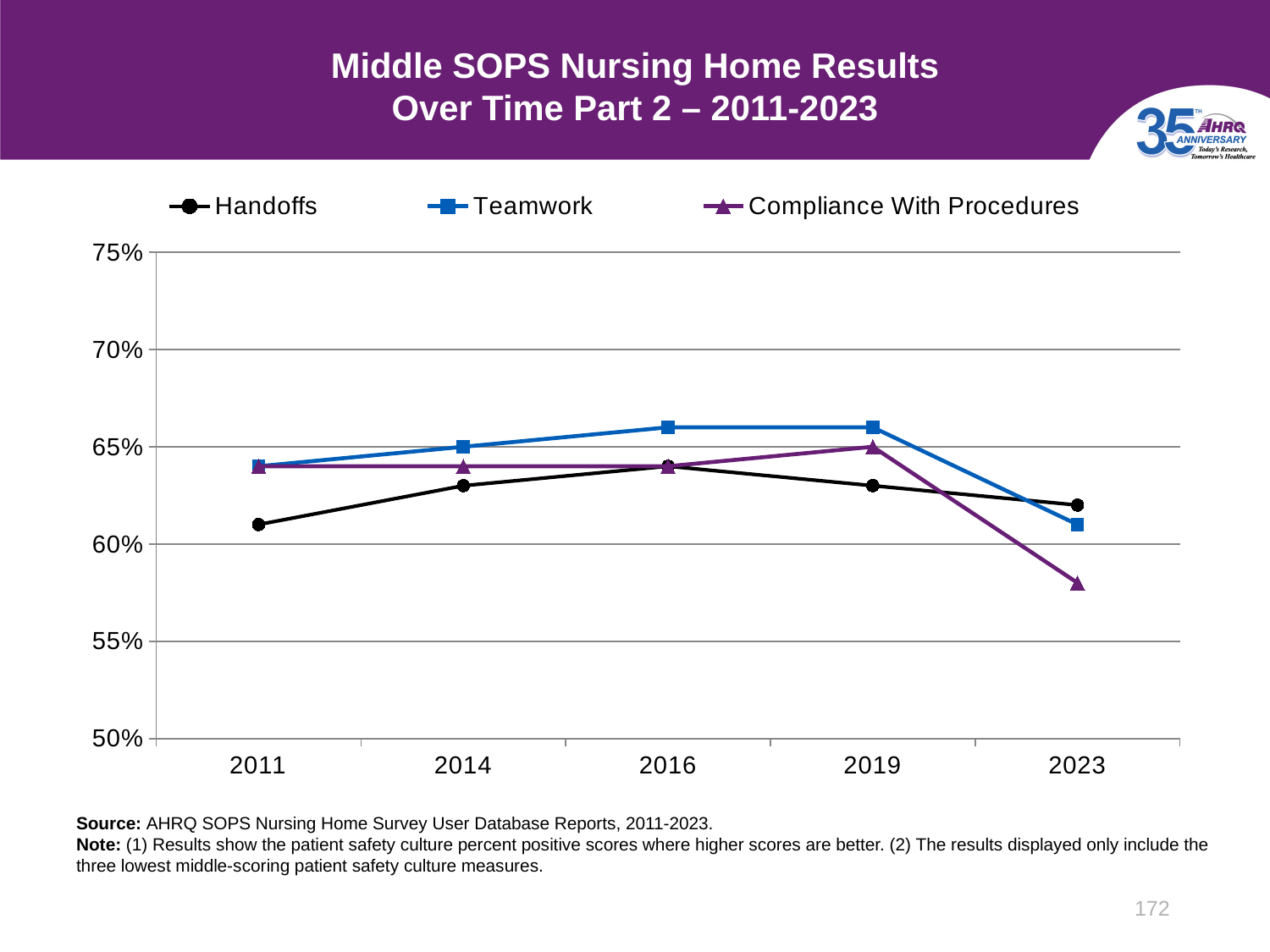
Is the value for Handoffs in 2023 greater or less than 65%? less How many series does the legend list? 3 Does the Compliance With Procedures line rise or fall from 2019 to 2023? Fall Which series has the lowest value in 2023? Compliance With Procedures Is the value for Handoffs in 2011 greater or less than 60%? greater In 2019, which is larger: Teamwork or Handoffs? Teamwork Is the value for Compliance With Procedures in 2023 greater or less than 60%? less In 2023, which is larger: Handoffs or Compliance With Procedures? Handoffs How many years are plotted along the x axis? 5 What kind of chart is shown on the slide? Line chart Which series is shown with a blue line and square markers? Teamwork